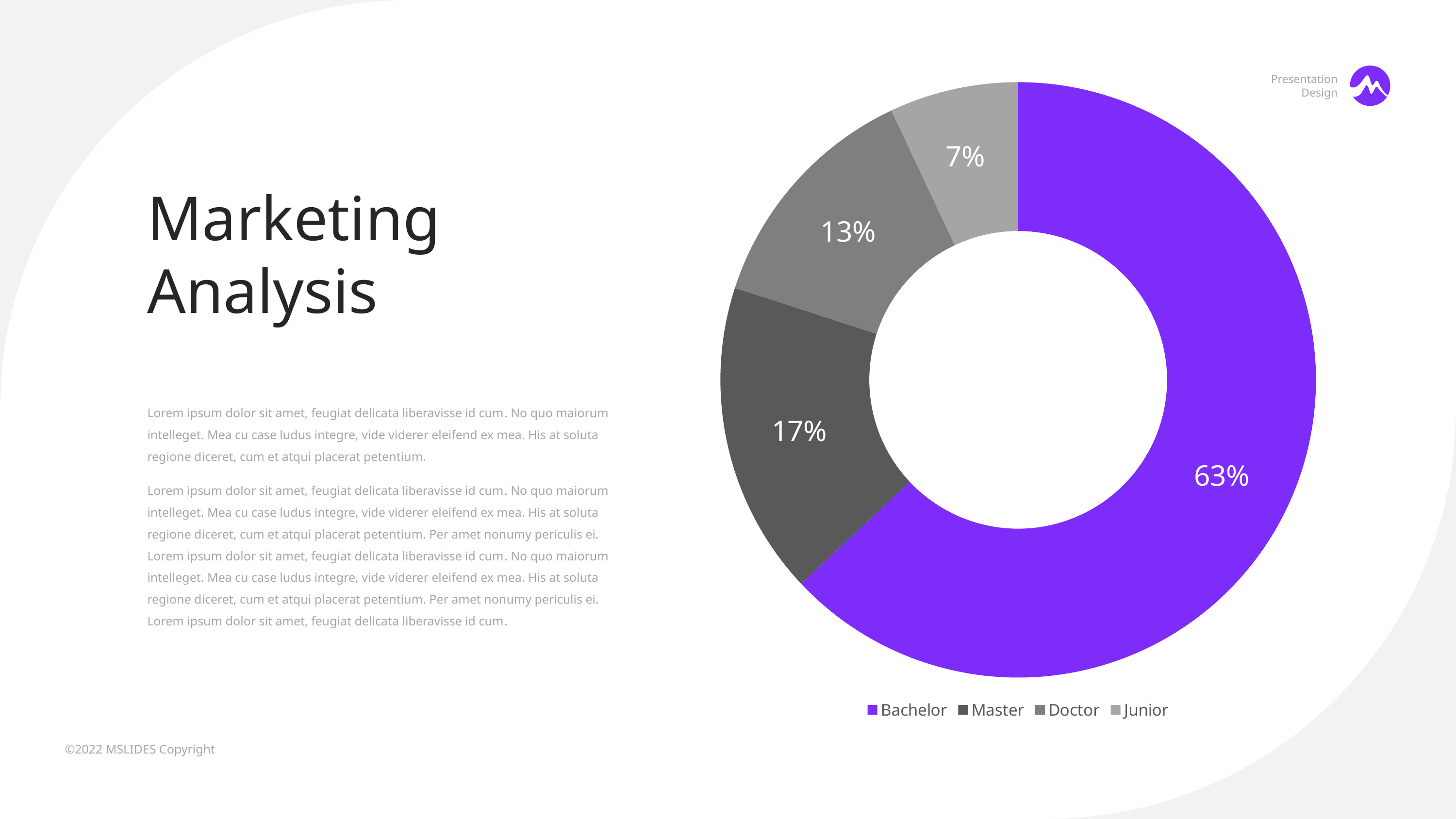
What percentage of the doughnut chart does Doctor account for? 13% Which category has the largest share in the doughnut chart? Bachelor What is the difference in percentage points between the Doctor and Junior shares? 6 What percentage of the doughnut chart does Junior account for? 7% Which has a larger share, Master or Doctor? Master Which category has the smallest share in the doughnut chart? Junior How many categories are shown in the doughnut chart? 4 What is the difference in percentage points between the Bachelor and Master shares? 46 What type of chart is shown on the slide? Doughnut chart What colour is the Bachelor slice in the doughnut chart? Purple What percentage of the doughnut chart does Bachelor account for? 63% What percentage of the doughnut chart does Master account for? 17%